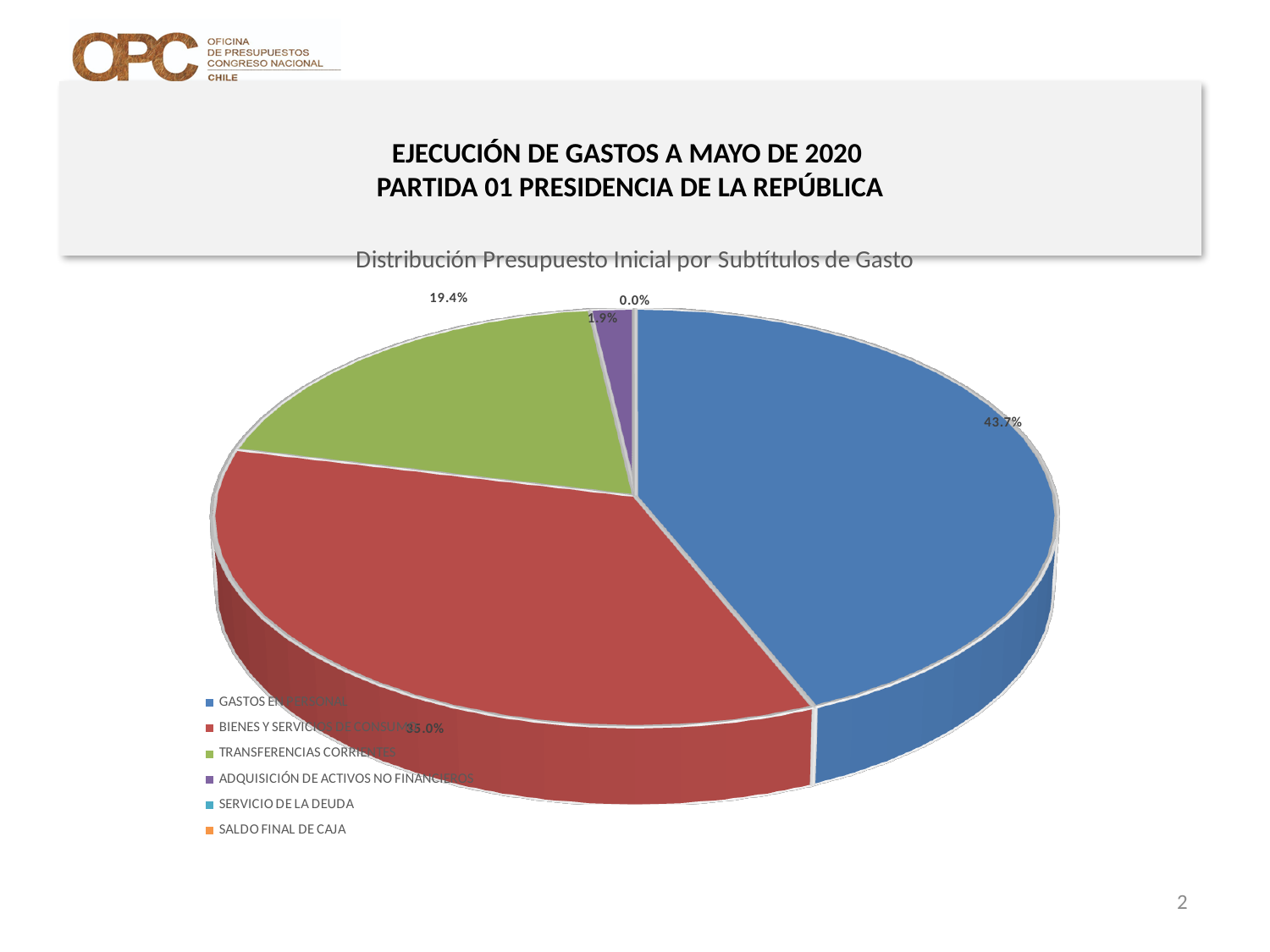
What percentage is shown for BIENES Y SERVICIOS DE CONSUMO? 35.0% What is the title of the chart? Distribución Presupuesto Inicial por Subtítulos de Gasto What is the difference in percentage points between GASTOS EN PERSONAL and BIENES Y SERVICIOS DE CONSUMO? 8.7 percentage points What colour is the slice for TRANSFERENCIAS CORRIENTES? Green What percentage is shown for TRANSFERENCIAS CORRIENTES? 19.4% What is the combined share of GASTOS EN PERSONAL and BIENES Y SERVICIOS DE CONSUMO? 78.7% Which is larger, the share for TRANSFERENCIAS CORRIENTES or the share for BIENES Y SERVICIOS DE CONSUMO? BIENES Y SERVICIOS DE CONSUMO What percentage is shown for ADQUISICIÓN DE ACTIVOS NO FINANCIEROS? 1.9% Which category has the largest share of the pie? GASTOS EN PERSONAL What kind of chart is shown on the slide? Pie chart What share of the pie does GASTOS EN PERSONAL represent? 43.7% How many categories does the legend list? 6